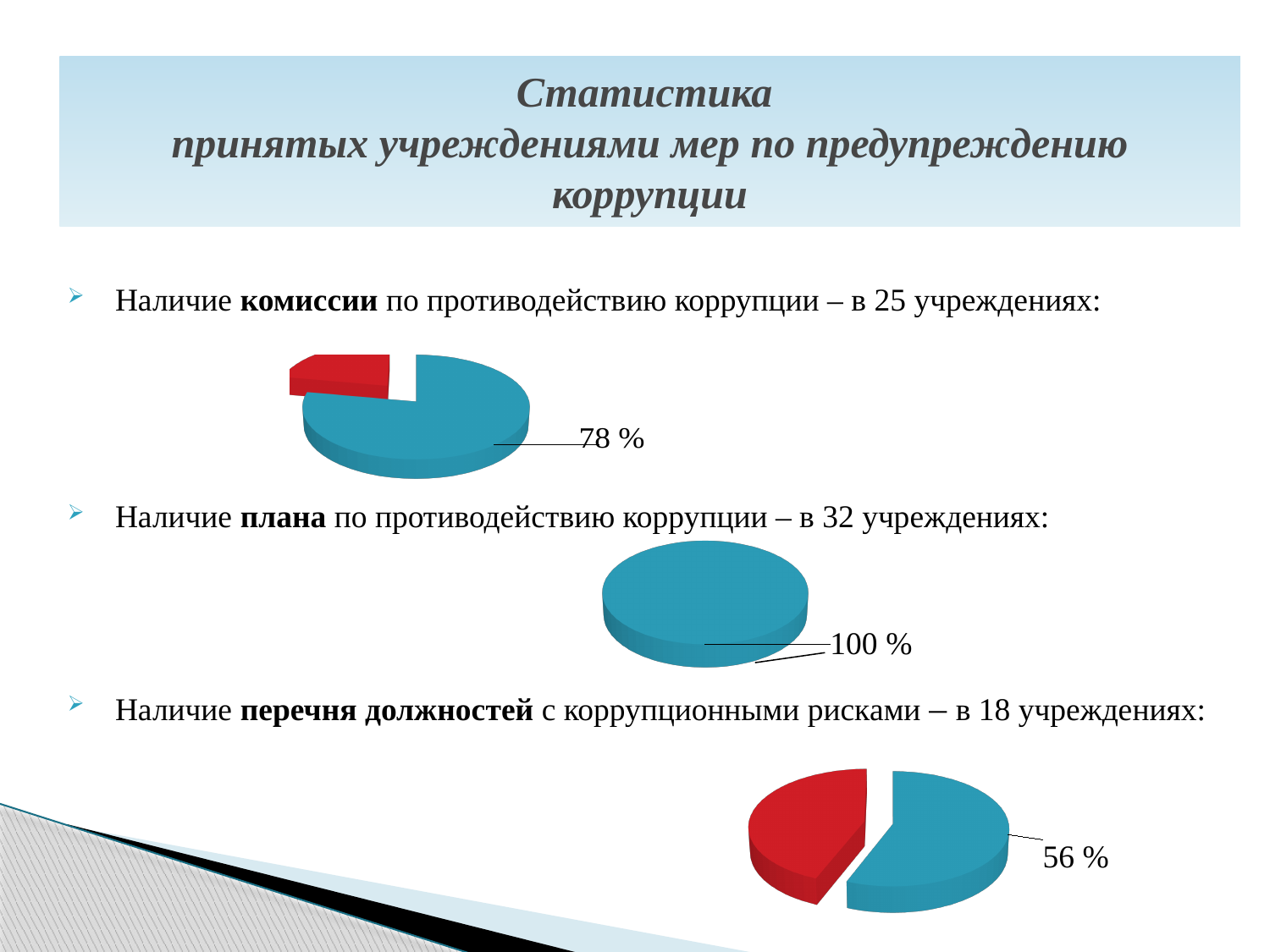
How many slices does the bottom pie chart have? 2 How many pie charts are shown on the slide? 3 Which of the three pie charts shows the highest labelled value? The middle chart (100 %) In the bottom pie chart (under the bullet about 'перечня должностей'), what value is printed on the data label? 56 % In the top pie chart (under the bullet about 'комиссии'), what value is printed on the data label? 78 % Which of the three pie charts shows the lowest labelled value? The bottom chart (56 %) How many slices does the top pie chart have? 2 In the top pie chart, which slice is larger, the blue one or the red one? The blue one How many slices does the middle pie chart have? 1 In the bottom pie chart, what colour is the slice labelled 56 %? Blue What kind of chart is used for the three charts on this slide? Pie chart In the middle pie chart (under the bullet about 'плана'), what value is printed on the data label? 100 %